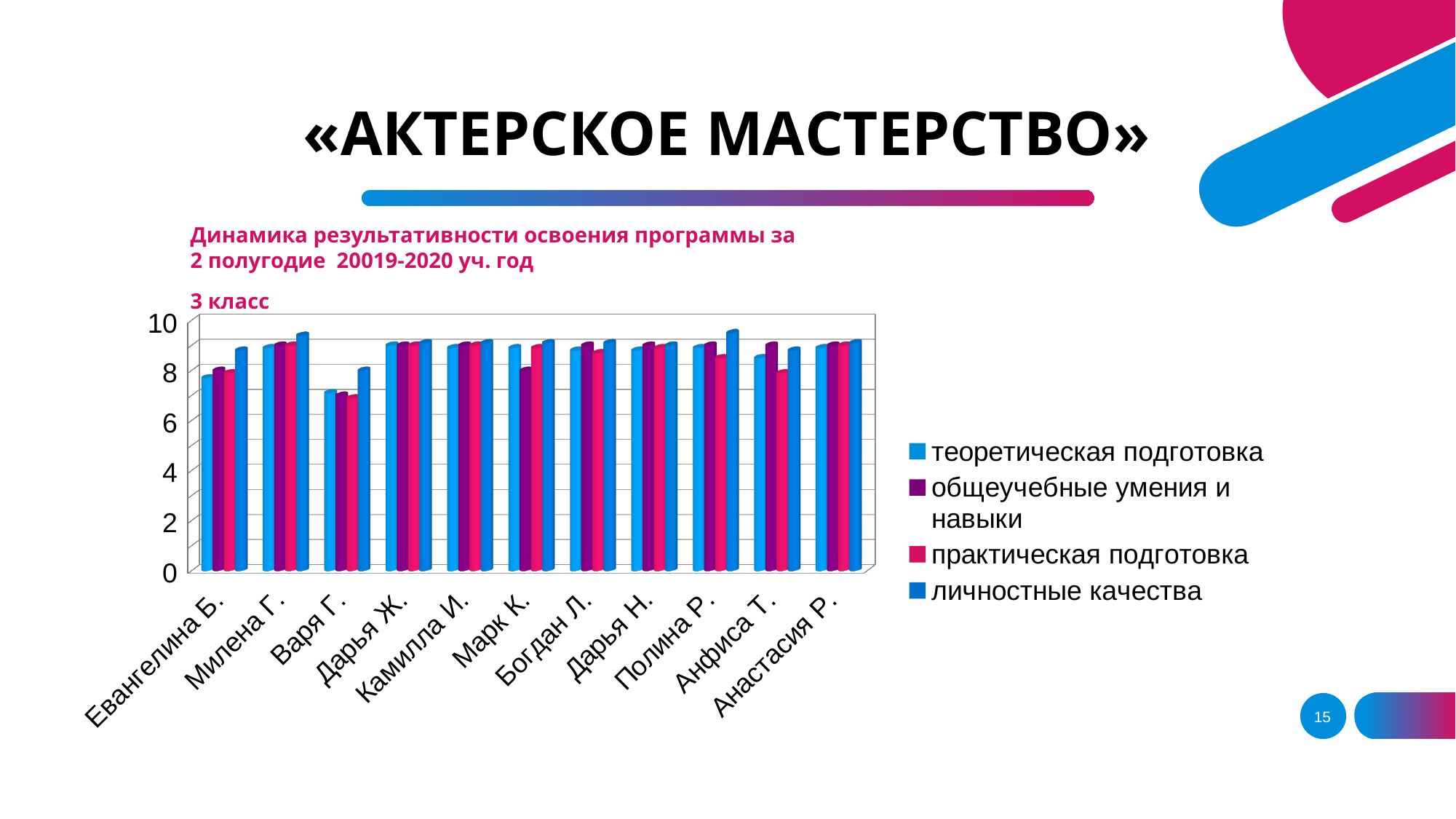
What is the first series listed in the chart legend? теоретическая подготовка Which student has the larger value for общеучебные умения и навыки: Варя Г. or Дарья Ж.? Дарья Ж. Is the value of личностные качества for Полина Р. greater or less than 8? greater What kind of chart is shown on the slide? bar chart How many students (categories) are shown on the x axis of the chart? 11 Which student has the lowest value for теоретическая подготовка? Варя Г. Is the value of теоретическая подготовка for Варя Г. greater or less than 8? less How many series does the chart legend list? 4 Is the value of практическая подготовка for Варя Г. greater or less than 8? less Which student has the larger value for теоретическая подготовка: Варя Г. or Милена Г.? Милена Г. Which class is the chart labelled as showing? 3 класс